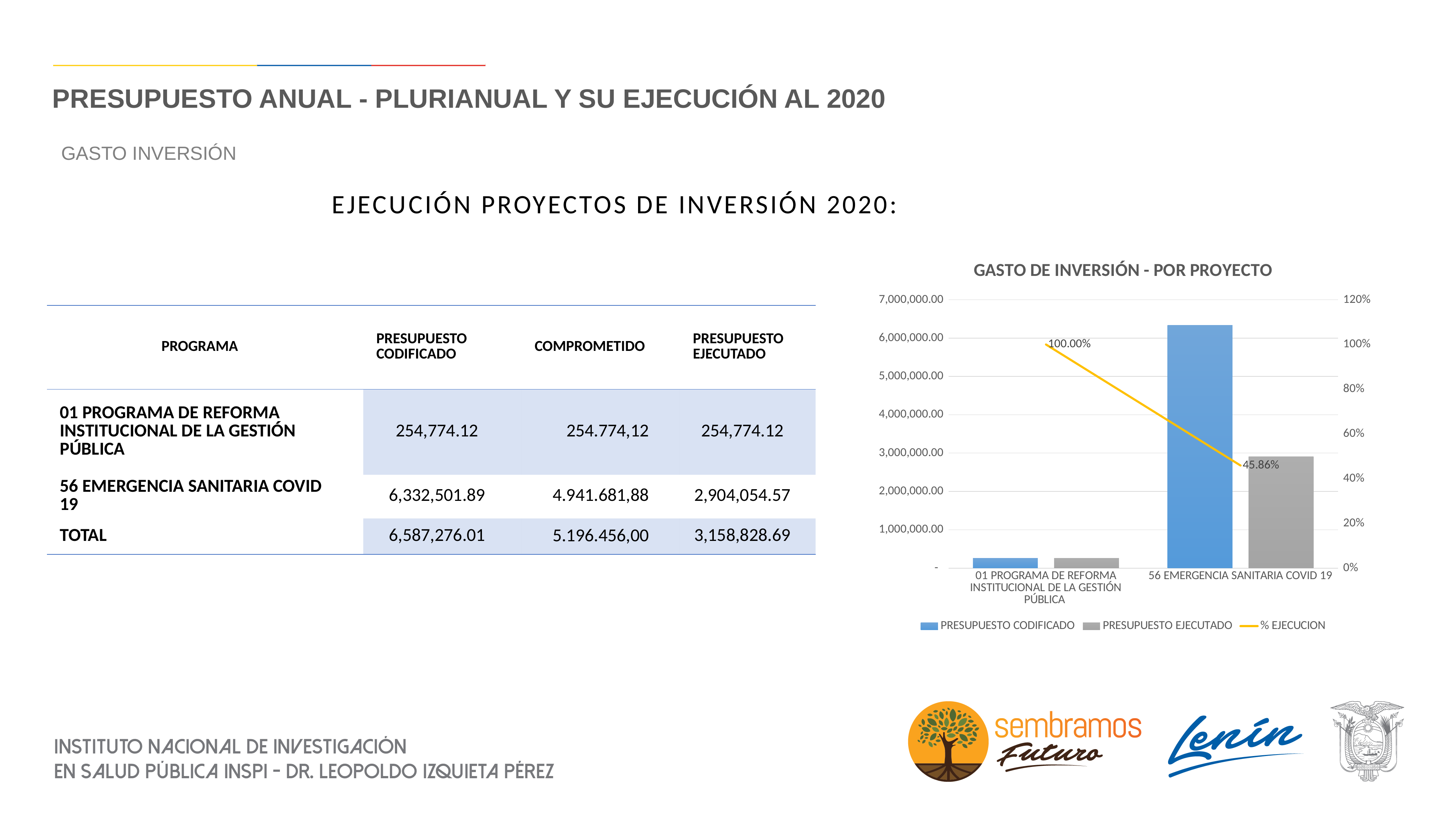
In the "GASTO DE INVERSIÓN - POR PROYECTO" chart, what is the % EJECUCION for 01 PROGRAMA DE REFORMA INSTITUCIONAL DE LA GESTIÓN PÚBLICA? 100.00% What kind of chart is "GASTO DE INVERSIÓN - POR PROYECTO"? Bar chart with a line How many categories are shown on the x axis of the "GASTO DE INVERSIÓN - POR PROYECTO" chart? 2 How many series does the legend of the "GASTO DE INVERSIÓN - POR PROYECTO" chart list? 3 In the "GASTO DE INVERSIÓN - POR PROYECTO" chart, which is larger for 56 EMERGENCIA SANITARIA COVID 19: PRESUPUESTO CODIFICADO or PRESUPUESTO EJECUTADO? PRESUPUESTO CODIFICADO In the "GASTO DE INVERSIÓN - POR PROYECTO" chart, which category has the highest PRESUPUESTO CODIFICADO? 56 EMERGENCIA SANITARIA COVID 19 In the "GASTO DE INVERSIÓN - POR PROYECTO" chart, what is the difference in % EJECUCION between 01 PROGRAMA DE REFORMA INSTITUCIONAL DE LA GESTIÓN PÚBLICA and 56 EMERGENCIA SANITARIA COVID 19? 54.14% In the "GASTO DE INVERSIÓN - POR PROYECTO" chart, is the PRESUPUESTO EJECUTADO for 56 EMERGENCIA SANITARIA COVID 19 greater or less than 2,000,000.00? greater In the "GASTO DE INVERSIÓN - POR PROYECTO" chart, is the PRESUPUESTO CODIFICADO for 56 EMERGENCIA SANITARIA COVID 19 greater or less than 6,000,000.00? greater In the "GASTO DE INVERSIÓN - POR PROYECTO" chart, is the PRESUPUESTO CODIFICADO for 01 PROGRAMA DE REFORMA INSTITUCIONAL DE LA GESTIÓN PÚBLICA greater or less than 1,000,000.00? less In the "GASTO DE INVERSIÓN - POR PROYECTO" chart, does the % EJECUCION line rise or fall from the first category to the second? fall In the "GASTO DE INVERSIÓN - POR PROYECTO" chart, what is the % EJECUCION for 56 EMERGENCIA SANITARIA COVID 19? 45.86%